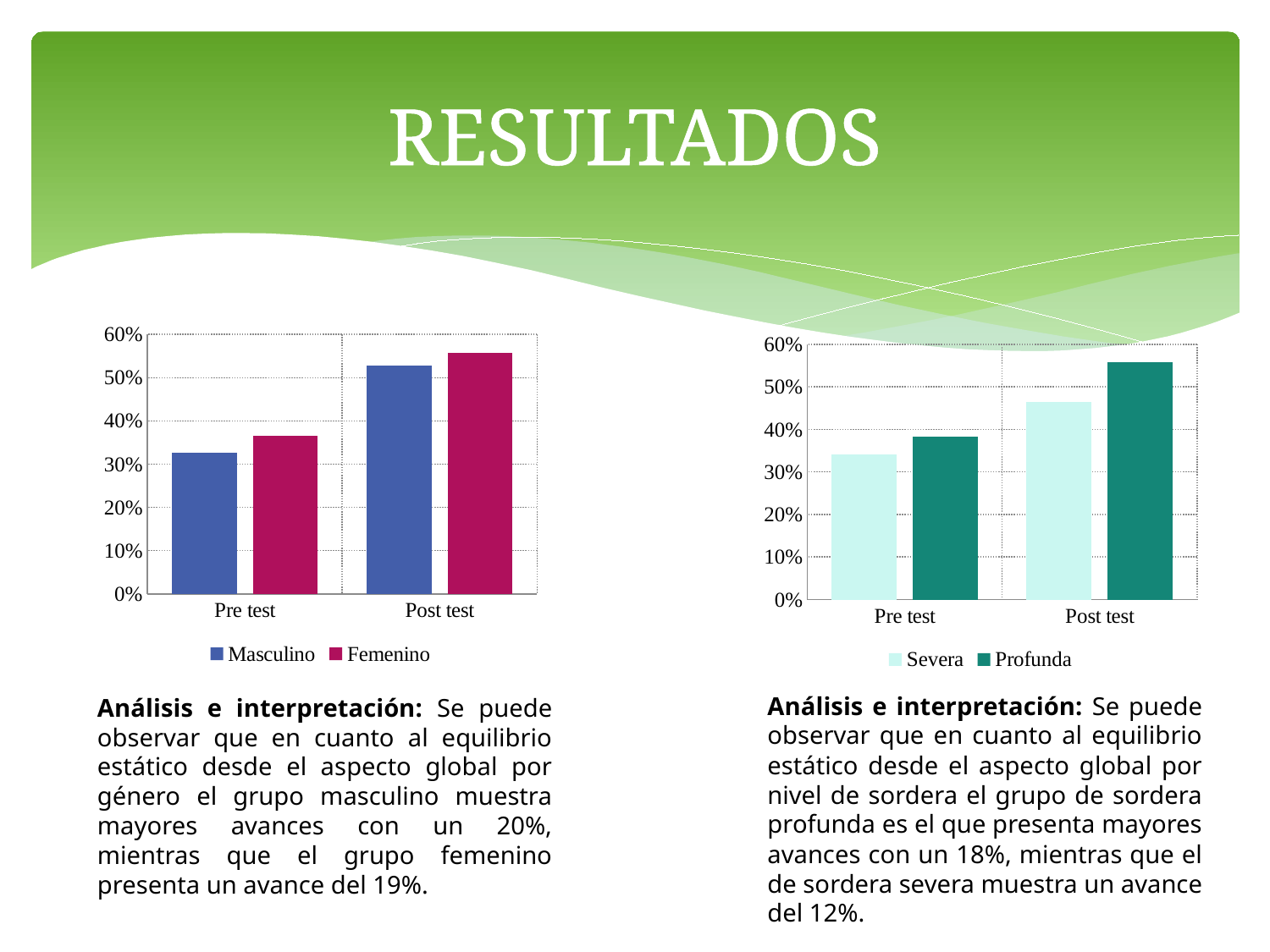
In the right chart, which bar is the highest? Profunda, Post test In the right chart, is the Severa value for Post test greater or less than 40%? greater In the left chart, is the Masculino value for Pre test greater or less than 40%? less What kind of chart is the left chart with the Masculino and Femenino legend? bar chart In the right chart, which is larger for Post test, Severa or Profunda? Profunda In the left chart, do the Masculino values rise or fall from Pre test to Post test? rise What are the two series named in the legend of the right chart? Severa and Profunda How many series does the legend of the left chart list? 2 How many categories are shown on the x axis of the right chart? 2 In the left chart, which is larger for Post test, Masculino or Femenino? Femenino In the left chart, is the Femenino value for Post test greater or less than 50%? greater